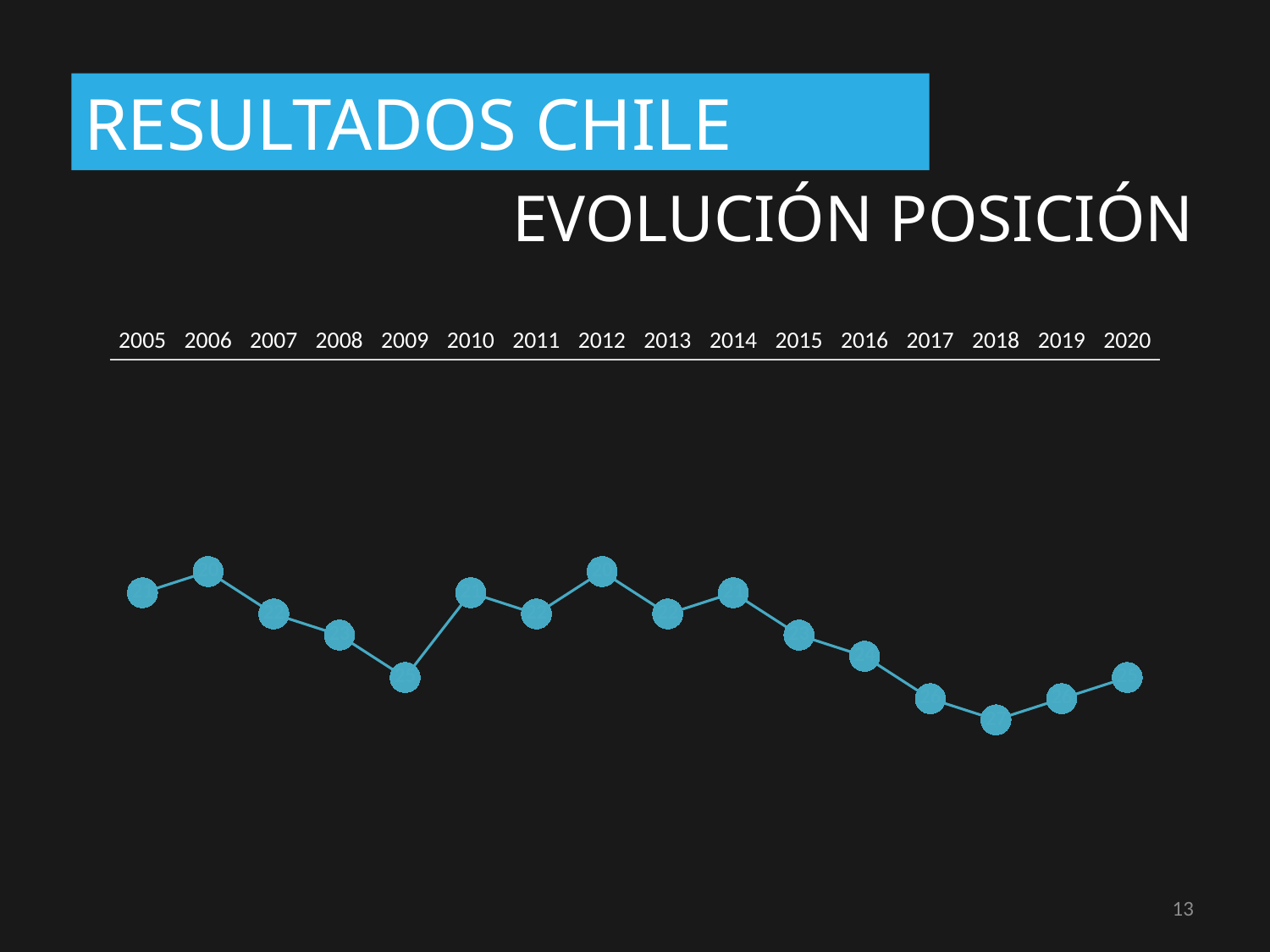
What is the first year shown on the x axis of the chart? 2005 What is the title shown above the chart? EVOLUCIÓN POSICIÓN Which year has the lowest plotted point on the chart? 2018 Does the line rise or fall between 2014 and 2018? fall Overall, does the line rise or fall from 2005 to 2020? fall How many data points are plotted on the line chart? 16 Does the line rise or fall between 2018 and 2020? rise Is the point for 2020 plotted higher or lower than the point for 2005? lower Is the point for 2010 plotted higher or lower than the point for 2009? higher What kind of chart is shown on the slide? line chart Is the point for 2017 plotted higher or lower than the point for 2018? higher